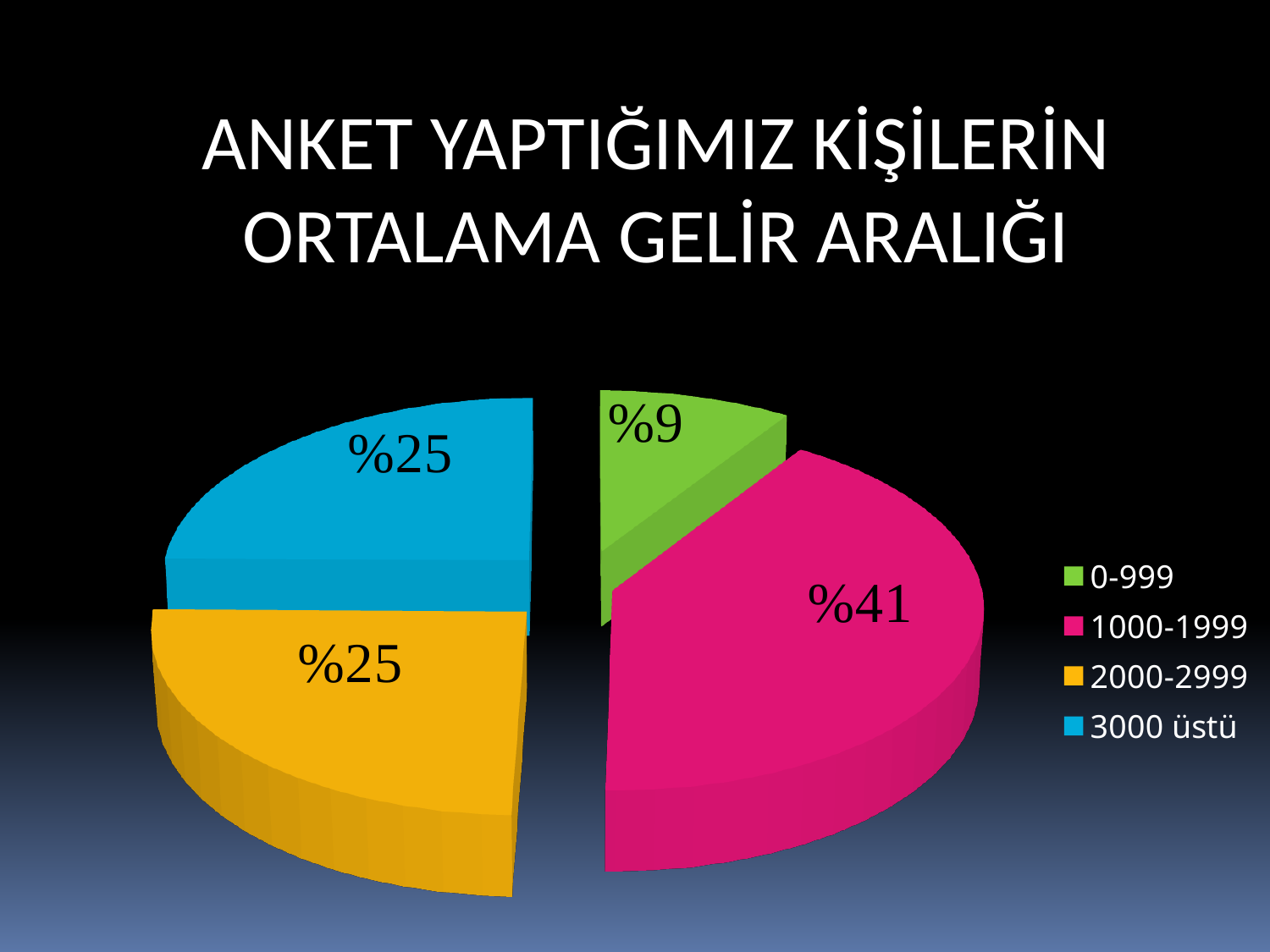
What value is shown for the 2000-2999 category? %25 Which income range has the smallest share of the pie? 0-999 What share of the pie does the 1000-1999 category have? %41 How many categories are shown in the pie chart? 4 Which is larger, the share for 1000-1999 or the share for 2000-2999? 1000-1999 What is the title of the slide? ANKET YAPTIĞIMIZ KİŞİLERİN ORTALAMA GELİR ARALIĞI Which income range has the largest share of the pie? 1000-1999 Which category is represented by the green slice? 0-999 What value is shown for the 3000 üstü category? %25 What kind of chart is shown on the slide? Pie chart What is the difference between the shares of the 1000-1999 and 0-999 categories? %32 What value is shown for the 0-999 category? %9